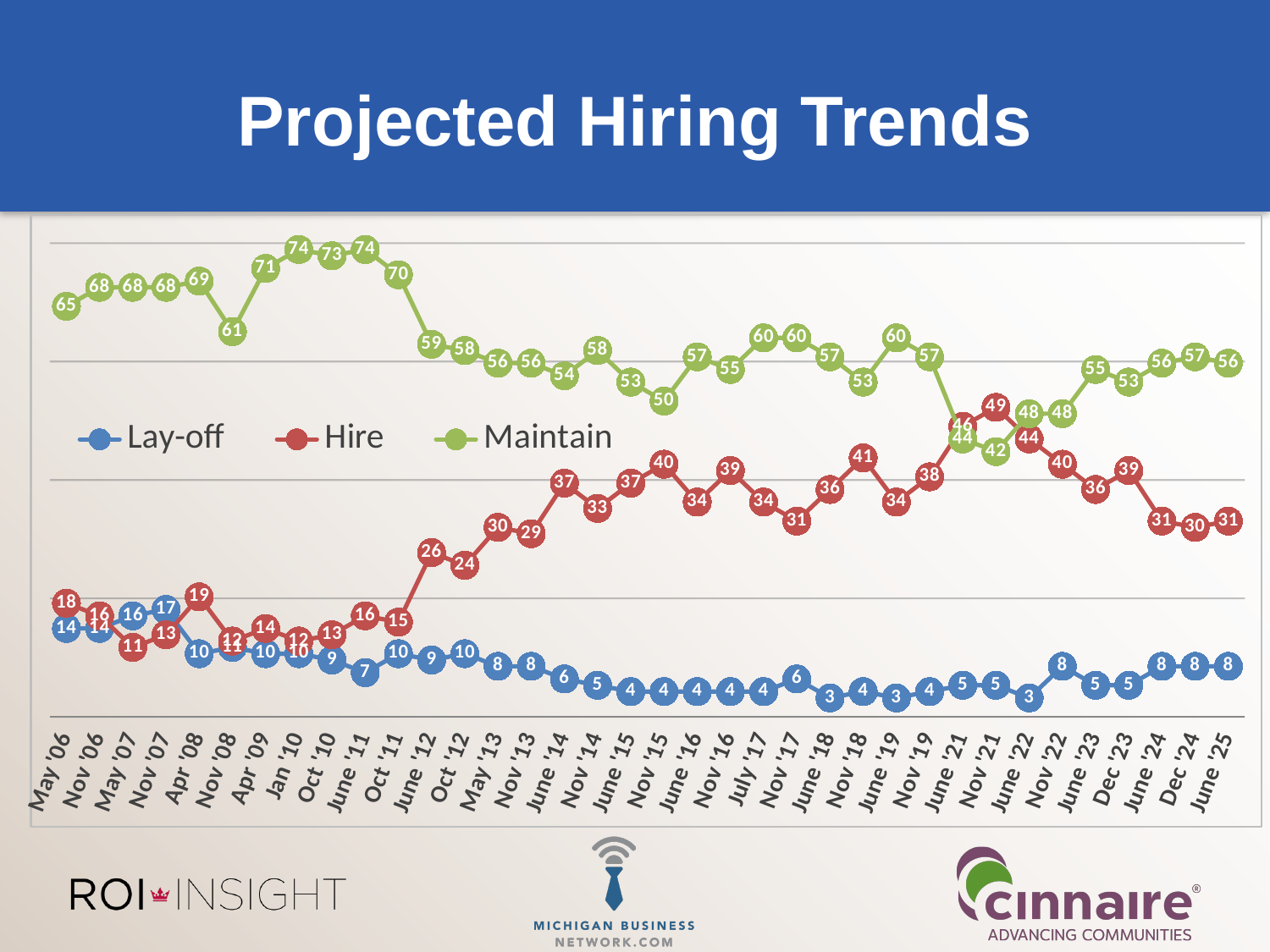
What kind of chart is shown on the slide? Line chart Which is larger for June '25, the Hire value or the Lay-off value? Hire What is the Maintain value for May '06? 65 What is the Maintain value for Nov '15? 50 At which date does the Hire series reach its highest value? Nov '21 What is the highest value reached by the Maintain series? 74 At which date does the Maintain series reach its lowest value? Nov '21 What is the Hire value for June '25? 31 What is the difference between the Maintain and Hire values for June '25? 25 How many series does the legend list? 3 What is the Lay-off value for June '25? 8 Does the Lay-off series generally rise or fall from May '06 to June '25? Fall